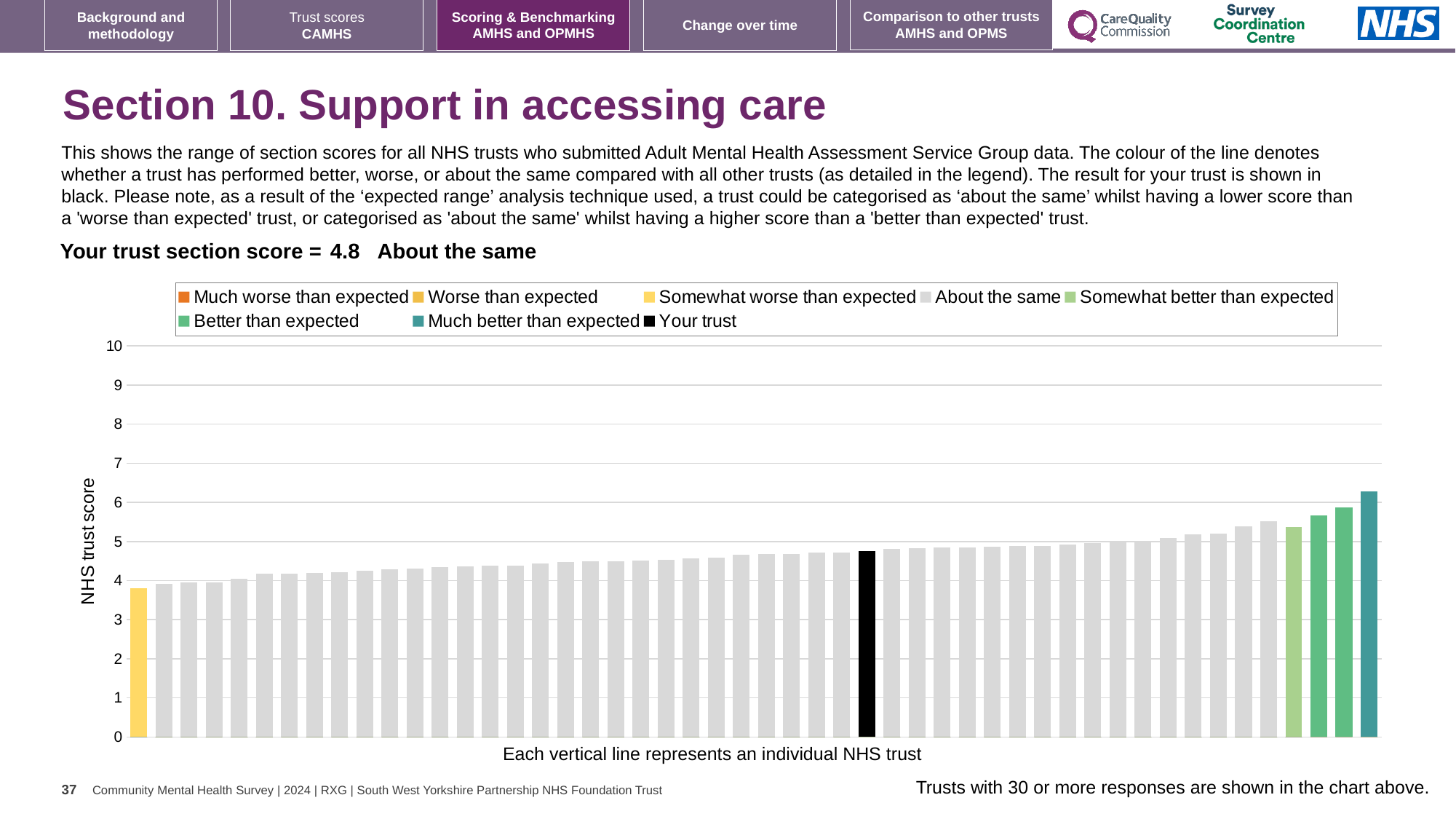
How many entries does the chart legend list? 8 Is the value of the black 'Your trust' bar greater or less than 4? greater What kind of chart is shown on the slide? bar chart Is the value of the tallest bar in the chart greater or less than 6? greater According to the x-axis label, what does each vertical line in the chart represent? an individual NHS trust What is the label on the vertical axis of the chart? NHS trust score Do the bar values rise or fall from left to right along the x axis? rise Is the tallest bar larger or smaller than the black 'Your trust' bar? larger Is the value of the shortest bar in the chart greater or less than 5? less What is the section score for your trust shown on the slide? 4.8